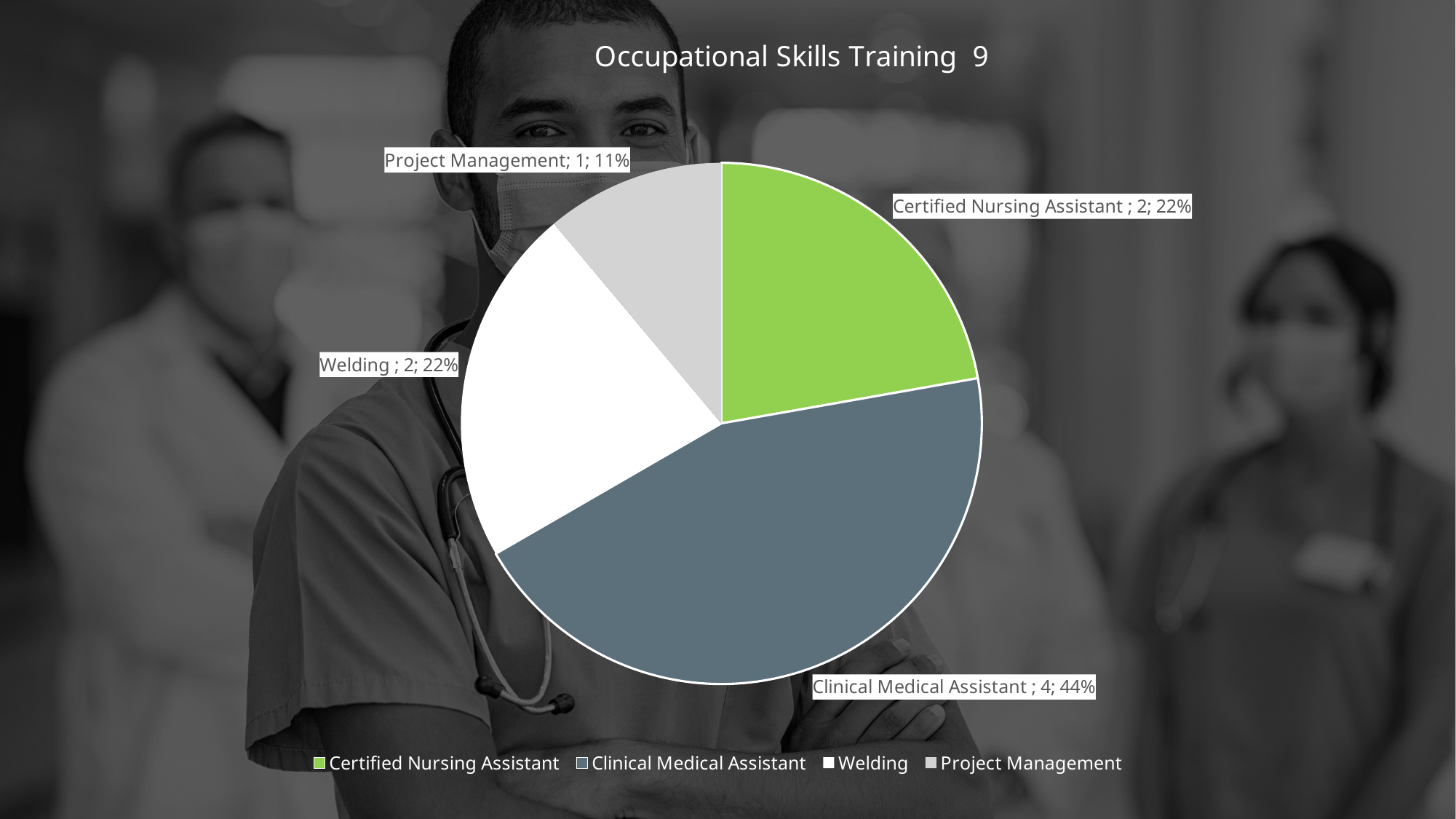
What percentage share does Welding have? 22% Which category has the largest slice? Clinical Medical Assistant What is the difference between the values for Clinical Medical Assistant and Project Management? 3 What is the value for Clinical Medical Assistant? 4 How many categories does the pie chart have? 4 What is the title of the chart? Occupational Skills Training 9 Which is larger, the value for Certified Nursing Assistant or the value for Project Management? Certified Nursing Assistant What type of chart is shown on the slide? pie chart Which category has the smallest slice? Project Management How many entries does the legend list? 4 What percentage share does Certified Nursing Assistant have? 22% What is the value for Project Management? 1